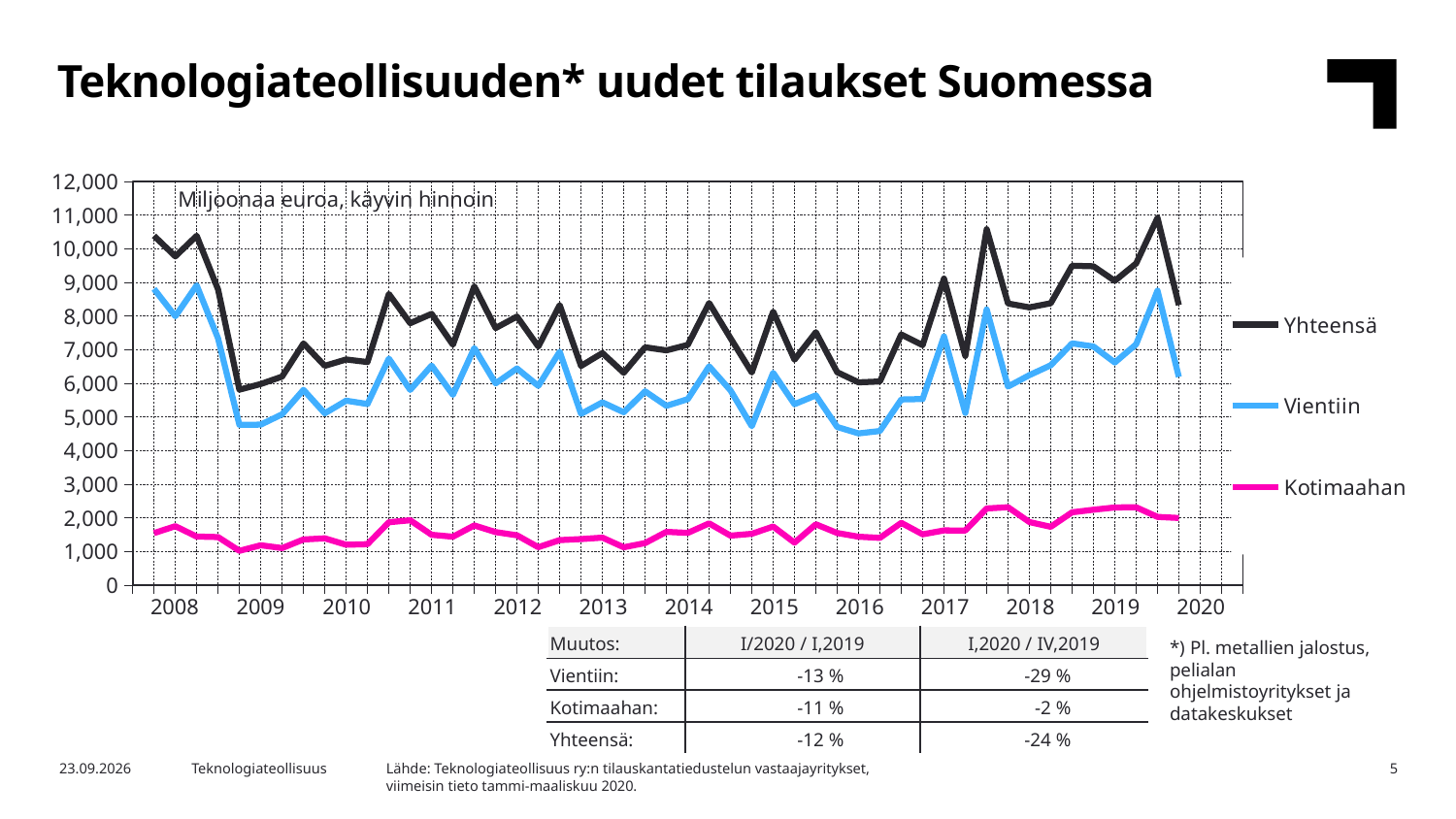
What unit is stated in the text box inside the chart? Miljoonaa euroa, käyvin hinnoin How many series does the legend list? 3 Does the Yhteensä series rise or fall from the start of 2008 to the start of 2009? fall Which series has the highest values throughout the chart? Yhteensä Is the lowest value for Vientiin in 2016 greater or less than 5,000? less Is the value for Kotimaahan at the start of 2008 greater or less than 3,000? less How many year labels are shown on the x axis? 13 Which is larger at the start of 2020, Vientiin or Kotimaahan? Vientiin What are the three series named in the legend? Yhteensä, Vientiin, Kotimaahan What kind of chart is shown on the slide? line chart Which series has the lowest values throughout the chart? Kotimaahan Is the value for Yhteensä at the start of 2008 greater or less than 10,000? greater